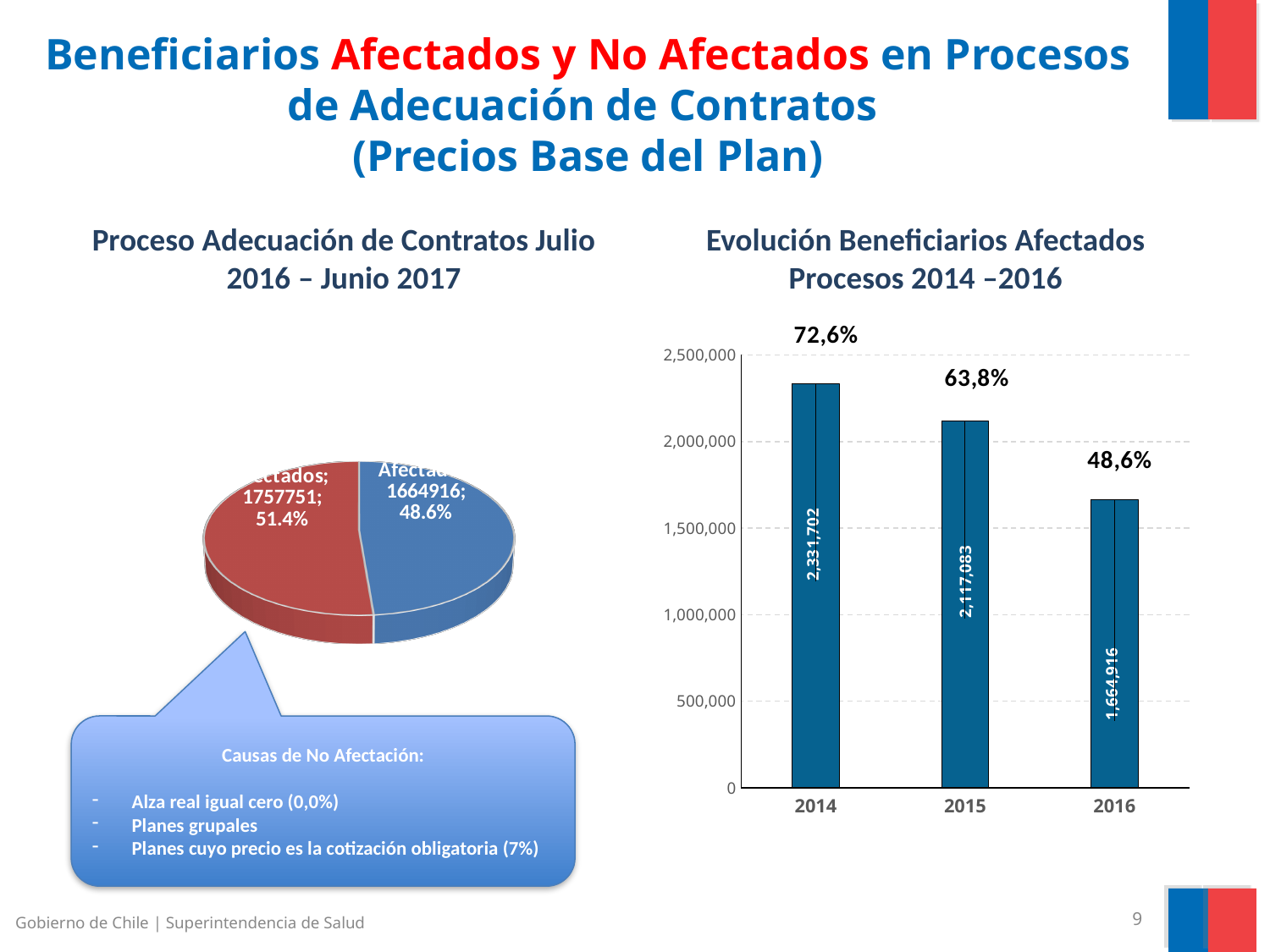
In the pie chart 'Proceso Adecuación de Contratos Julio 2016 – Junio 2017', what share of the pie is the Afectados slice? 48.6% In the bar chart 'Evolución Beneficiarios Afectados Procesos 2014 –2016', what is the difference between the 2014 and 2015 values? 214,619 In the bar chart 'Evolución Beneficiarios Afectados Procesos 2014 –2016', which year has the highest value? 2014 In the bar chart 'Evolución Beneficiarios Afectados Procesos 2014 –2016', which year has the lowest value? 2016 In the bar chart 'Evolución Beneficiarios Afectados Procesos 2014 –2016', what percentage is shown above the 2015 bar? 63,8% In the bar chart 'Evolución Beneficiarios Afectados Procesos 2014 –2016', do the values rise or fall from 2014 to 2016? fall How many bars are in the bar chart 'Evolución Beneficiarios Afectados Procesos 2014 –2016'? 3 What kind of chart is the chart on the left, 'Proceso Adecuación de Contratos Julio 2016 – Junio 2017'? pie chart In the pie chart 'Proceso Adecuación de Contratos Julio 2016 – Junio 2017', what is the value shown for the red slice? 1757751 In the bar chart 'Evolución Beneficiarios Afectados Procesos 2014 –2016', is the value for 2016 greater or less than 2,000,000? less In the bar chart 'Evolución Beneficiarios Afectados Procesos 2014 –2016', what is the value for 2016? 1,664,916 In the bar chart 'Evolución Beneficiarios Afectados Procesos 2014 –2016', what is the value for 2014? 2,331,702